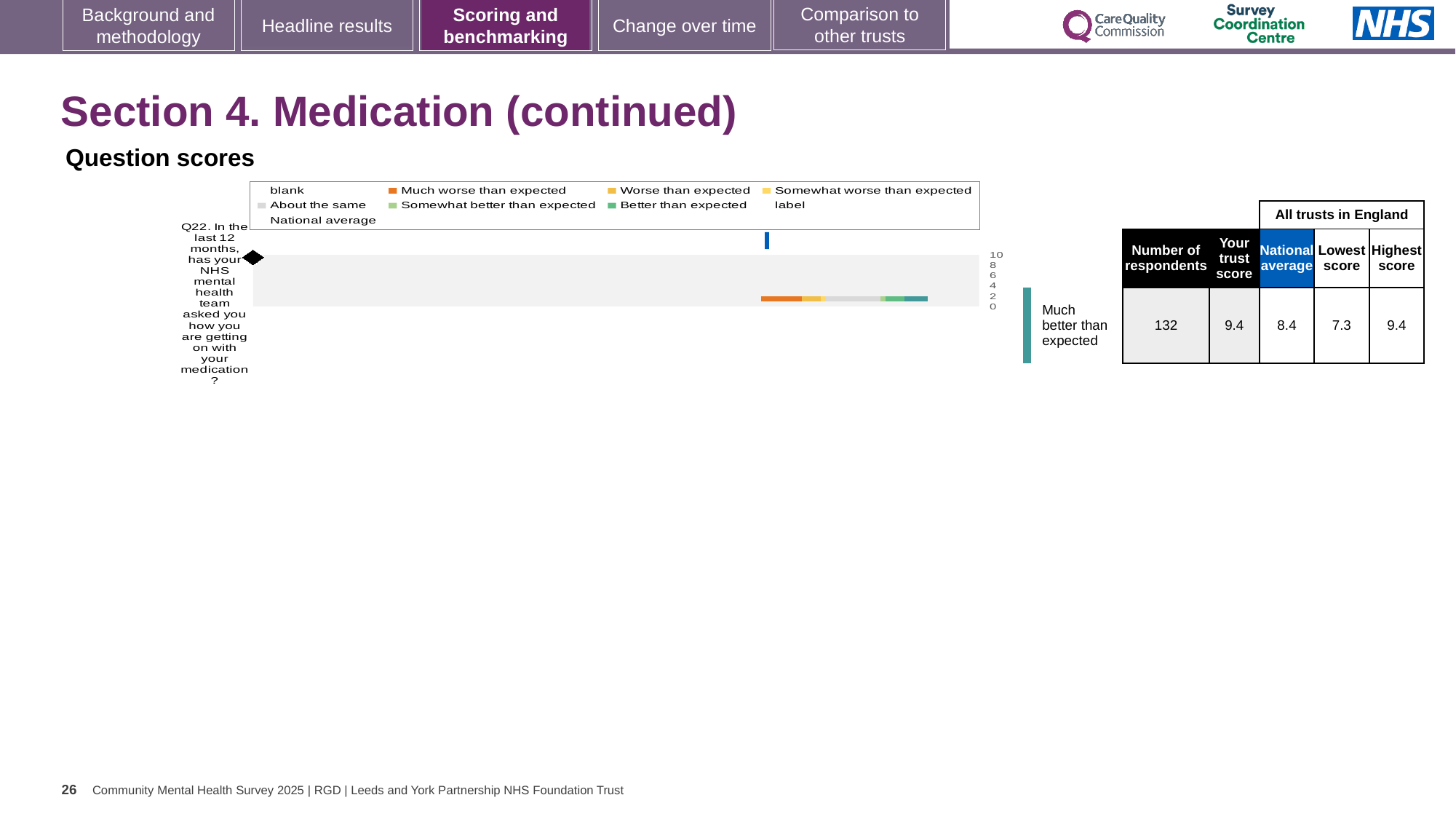
What is the 'Your trust score' value shown for Q22? 9.4 How many survey questions are plotted on the chart? 1 What kind of chart is shown under 'Question scores'? bar chart What is the difference between the trust score and the National average for Q22? 1.0 How many respondents are shown for Q22? 132 Which is larger for Q22, the trust score or the National average? Your trust score What is the National average score shown for Q22? 8.4 Which benchmark category label is shown next to the Q22 bar? Much better than expected What is the Lowest score among all trusts in England for Q22? 7.3 What is the Highest score among all trusts in England for Q22? 9.4 What is the difference between the Highest score and the Lowest score for Q22? 2.1 What is the maximum value shown on the chart's score axis? 10